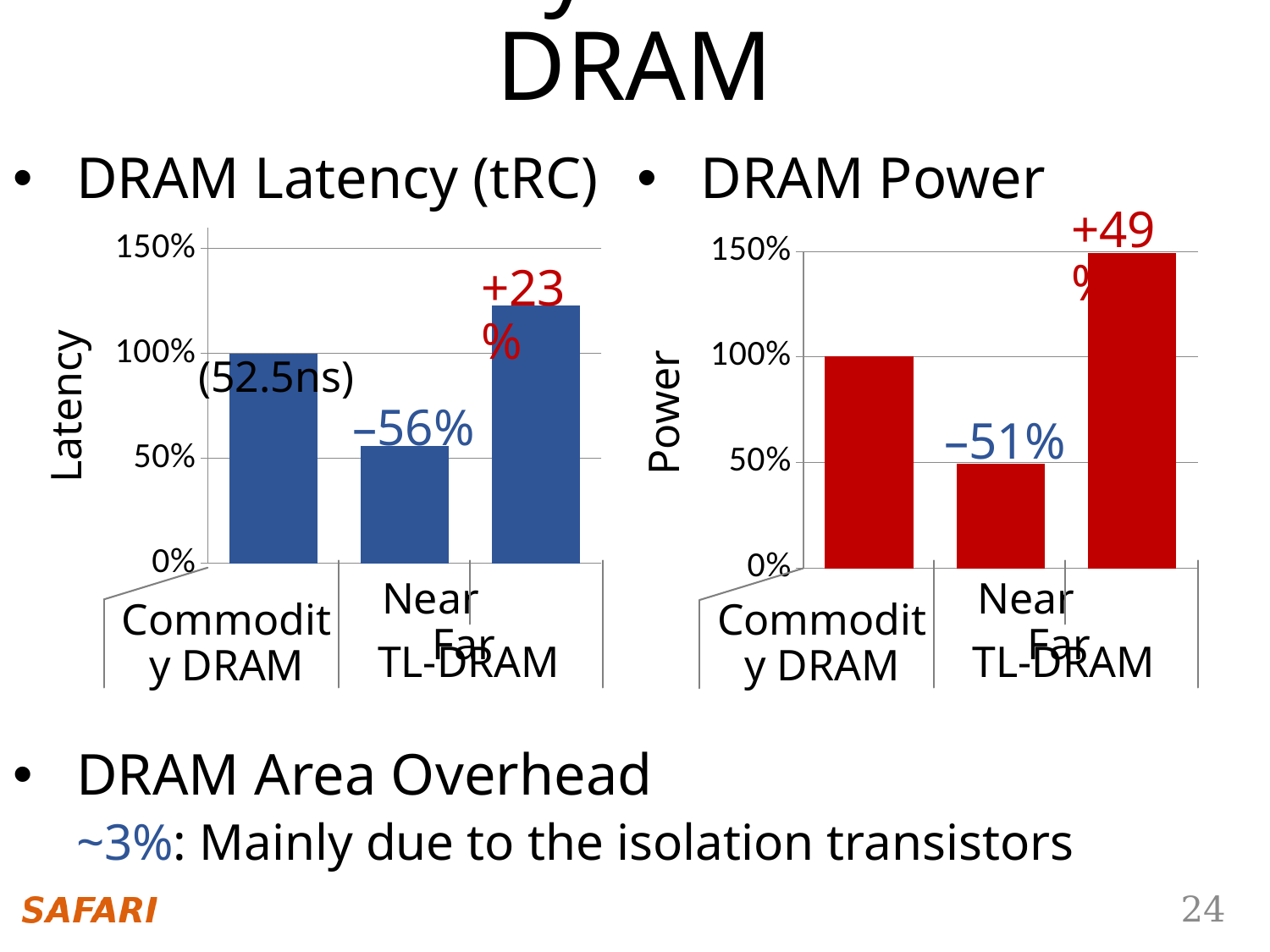
In the DRAM Latency (tRC) chart, is the value for Far greater or less than 100%? greater In the DRAM Latency (tRC) chart, what percentage change is annotated for the Far TL-DRAM bar? +23% In the DRAM Latency (tRC) chart, what kind of chart is shown? bar chart In the DRAM Latency (tRC) chart, what percentage change is annotated for the Near TL-DRAM bar? –56% In the DRAM Latency (tRC) chart, how many bars are plotted? 3 In the DRAM Latency (tRC) chart, what is the latency value for Commodity DRAM? 100% In the DRAM Power chart, is the value for Near greater or less than 100%? less In the DRAM Power chart, what percentage change is annotated for the Far TL-DRAM bar? +49% In the DRAM Latency (tRC) chart, what absolute latency is noted for Commodity DRAM? 52.5ns In the DRAM Power chart, which bar is the highest? Far In the DRAM Latency (tRC) chart, which bar is the lowest? Near In the DRAM Power chart, what percentage change is annotated for the Near TL-DRAM bar? –51%